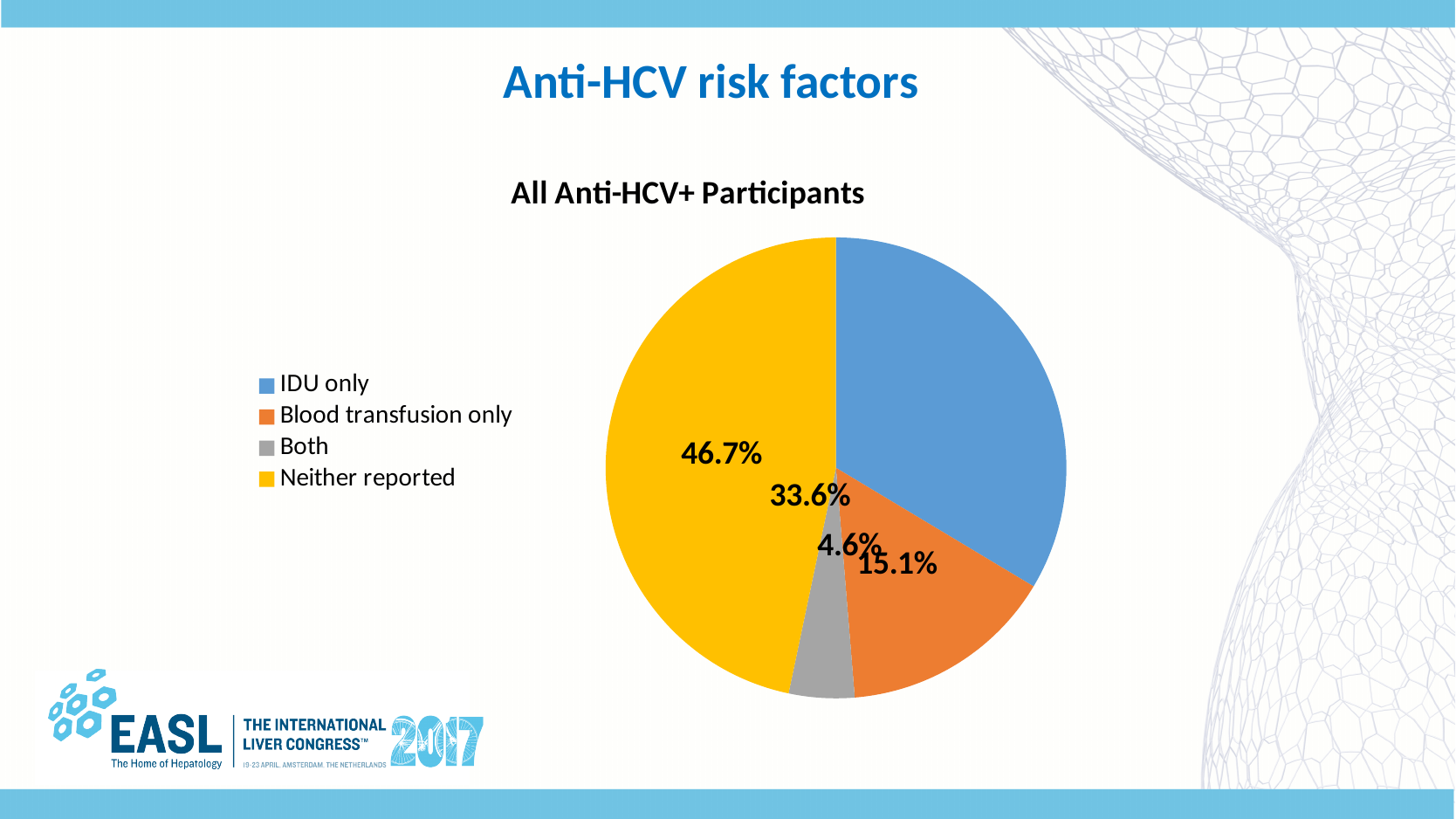
Which is larger: the share for 'IDU only' or for 'Blood transfusion only'? IDU only What is the chart's title? All Anti-HCV+ Participants Which category has the smallest share of the pie? Both What percentage of participants reported both risk factors? 4.6% How many categories does the legend list? 4 What percentage of participants reported blood transfusion only? 15.1% What percentage of participants reported neither risk factor? 46.7% What is the difference in percentage points between 'Neither reported' and 'IDU only'? 13.1 What type of chart is shown on the slide? Pie chart Which category has the largest share of the pie? Neither reported What percentage of participants reported IDU only? 33.6% Which colour represents 'Both' in the pie chart? Grey